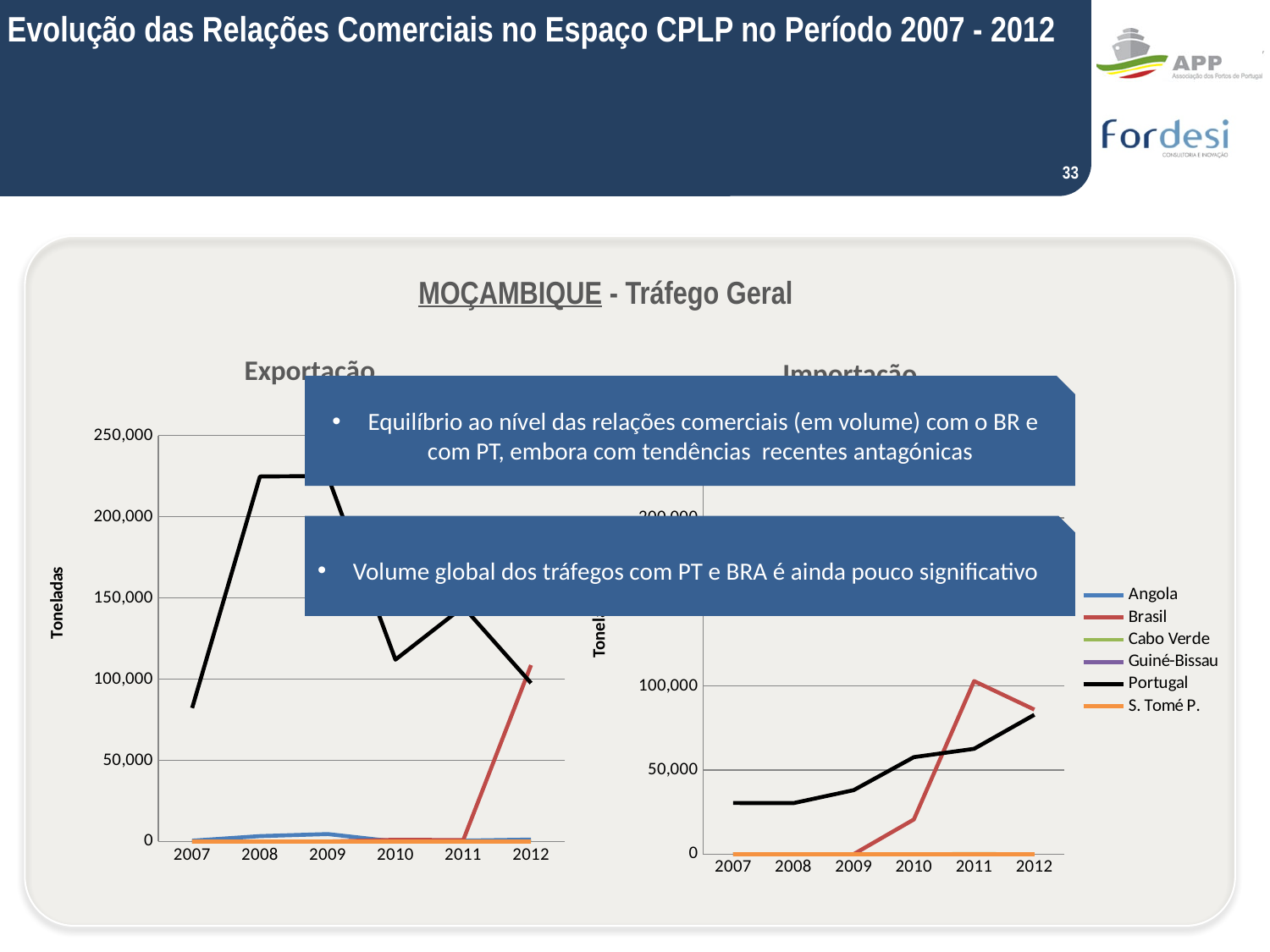
In the Importação chart, is the value for Portugal in 2012 greater or less than 100,000? less How many series does the legend list for the charts? 6 In the Importação chart, which is larger in 2011, Brasil or Portugal? Brasil In the Exportação chart, is the value for Brasil in 2012 greater or less than 100,000? greater What kind of chart is the Exportação chart on the left? line chart In the Exportação chart, is the value for Portugal in 2007 greater or less than 100,000? less How many years are shown on the x axis of the Importação chart? 6 In the Importação chart, does the Portugal line rise or fall from 2007 to 2012? rise In the Exportação chart, which is larger in 2008, Portugal or Angola? Portugal Which series reaches the highest value in the Exportação chart? Portugal